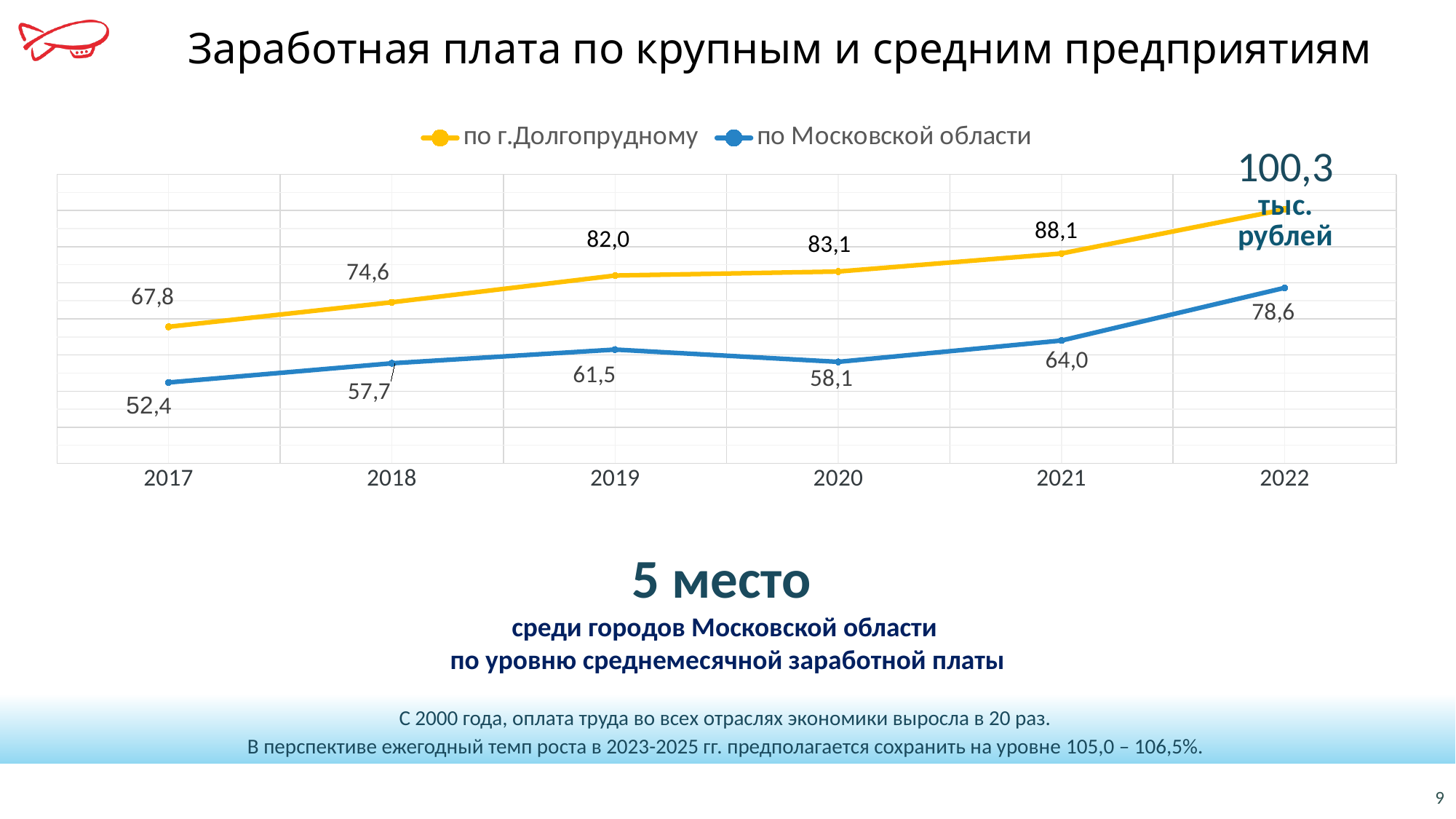
How many series does the chart legend list? 2 What is the value for "по г.Долгопрудному" in 2022? 100,3 Which is larger in 2018: the value for "по г.Долгопрудному" or for "по Московской области"? по г.Долгопрудному What is the value for "по Московской области" in 2020? 58,1 What is the value for "по г.Долгопрудному" in 2019? 82,0 In which year is the value for "по Московской области" the lowest? 2017 What type of chart is shown on the slide? line chart Which colour is used for the "по Московской области" series? blue How many years are plotted along the x axis of the chart? 6 In which year is the value for "по г.Долгопрудному" the highest? 2022 What is the difference between the "по г.Долгопрудному" and "по Московской области" values in 2021? 24,1 Does the "по г.Долгопрудному" series rise or fall from 2017 to 2022? rise